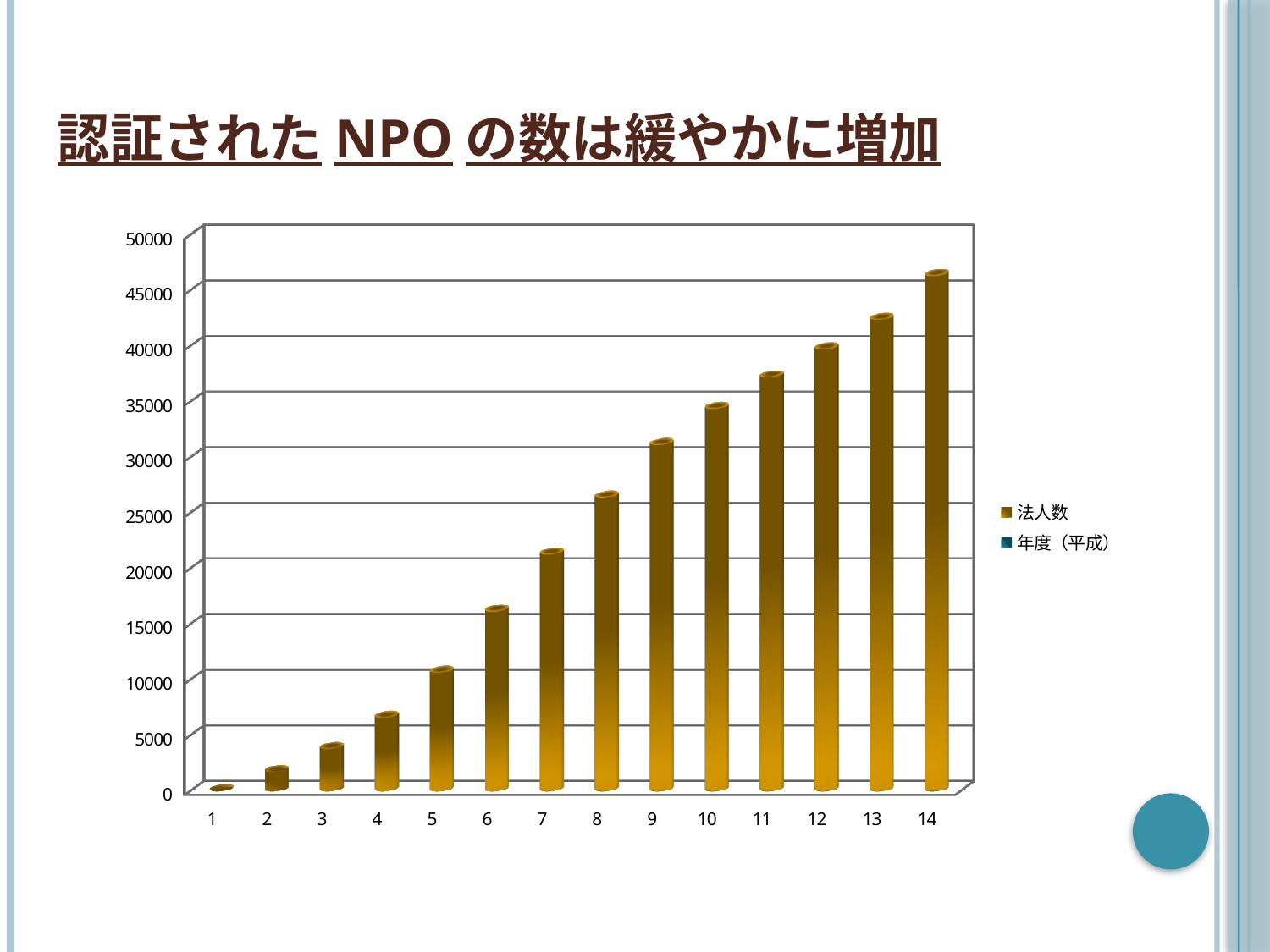
How many categories are shown on the x axis of the chart? 14 Is the value for category 7 greater or less than 15000? greater Is the value for category 10 greater or less than 30000? greater Which category has the highest value in the chart? 14 Is the value for category 14 greater or less than 40000? greater Do the values rise or fall from category 1 to category 14? rise What is the name of the series plotted in the chart, as shown in the legend? 法人数 and 年度（平成） Which has the larger value, category 9 or category 6? 9 What kind of chart is shown on the slide? bar chart Which category has the lowest value in the chart? 1 How many entries does the chart's legend list? 2